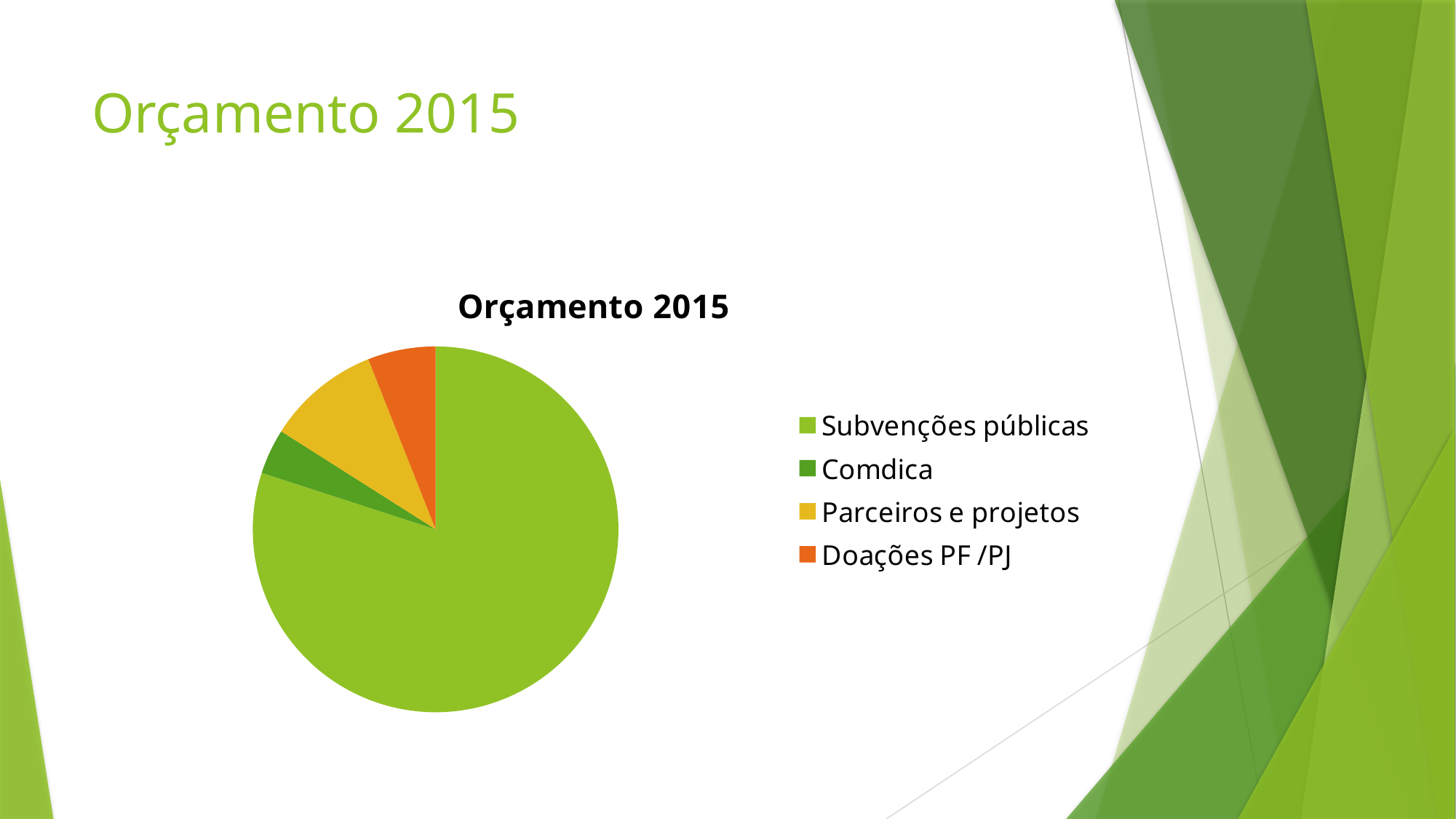
Which slice is larger, Parceiros e projetos or Comdica? Parceiros e projetos What kind of chart is shown on the slide? pie chart How many slices does the pie chart have? 4 What is the title of the chart? Orçamento 2015 How many entries does the legend list? 4 Which category has the largest slice of the pie? Subvenções públicas Which category has the smallest slice of the pie? Comdica Which slice is larger, Subvenções públicas or Doações PF /PJ? Subvenções públicas Which slice is larger, Parceiros e projetos or Doações PF /PJ? Parceiros e projetos Is the share of Subvenções públicas greater or less than half of the pie? greater What colour is the Doações PF /PJ slice? orange